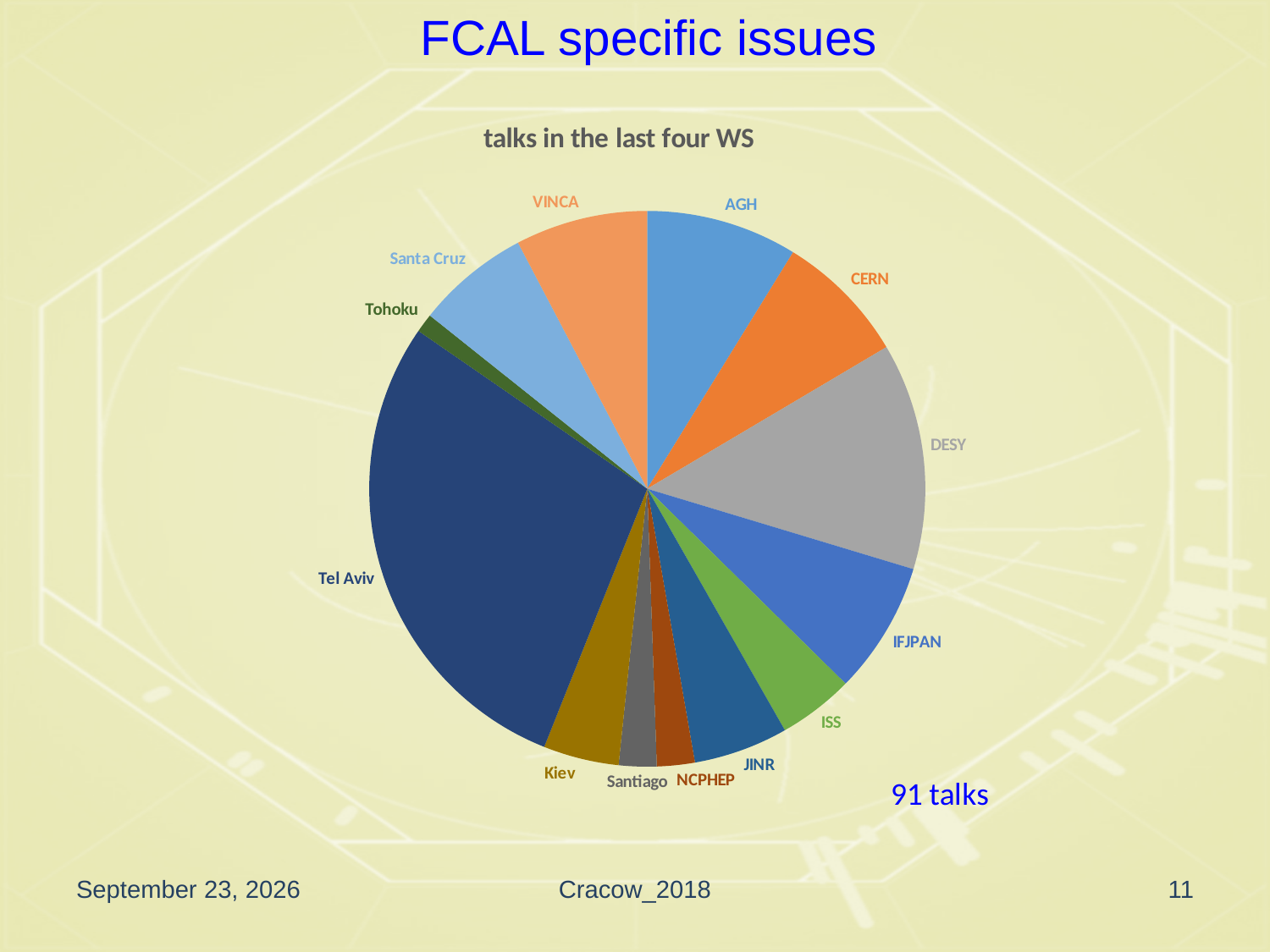
Which slice is larger, DESY or CERN? DESY What is the title of the chart? talks in the last four WS How many institutes (slices) are shown in the pie chart? 13 Which institute has the largest share of talks in the pie chart? Tel Aviv Which slice is larger, Kiev or Santiago? Kiev Which slice is larger, Tel Aviv or DESY? Tel Aviv According to the text next to the chart, how many talks are represented in total? 91 talks What kind of chart is shown on the slide? pie chart Which institute has the smallest slice in the pie chart? Tohoku